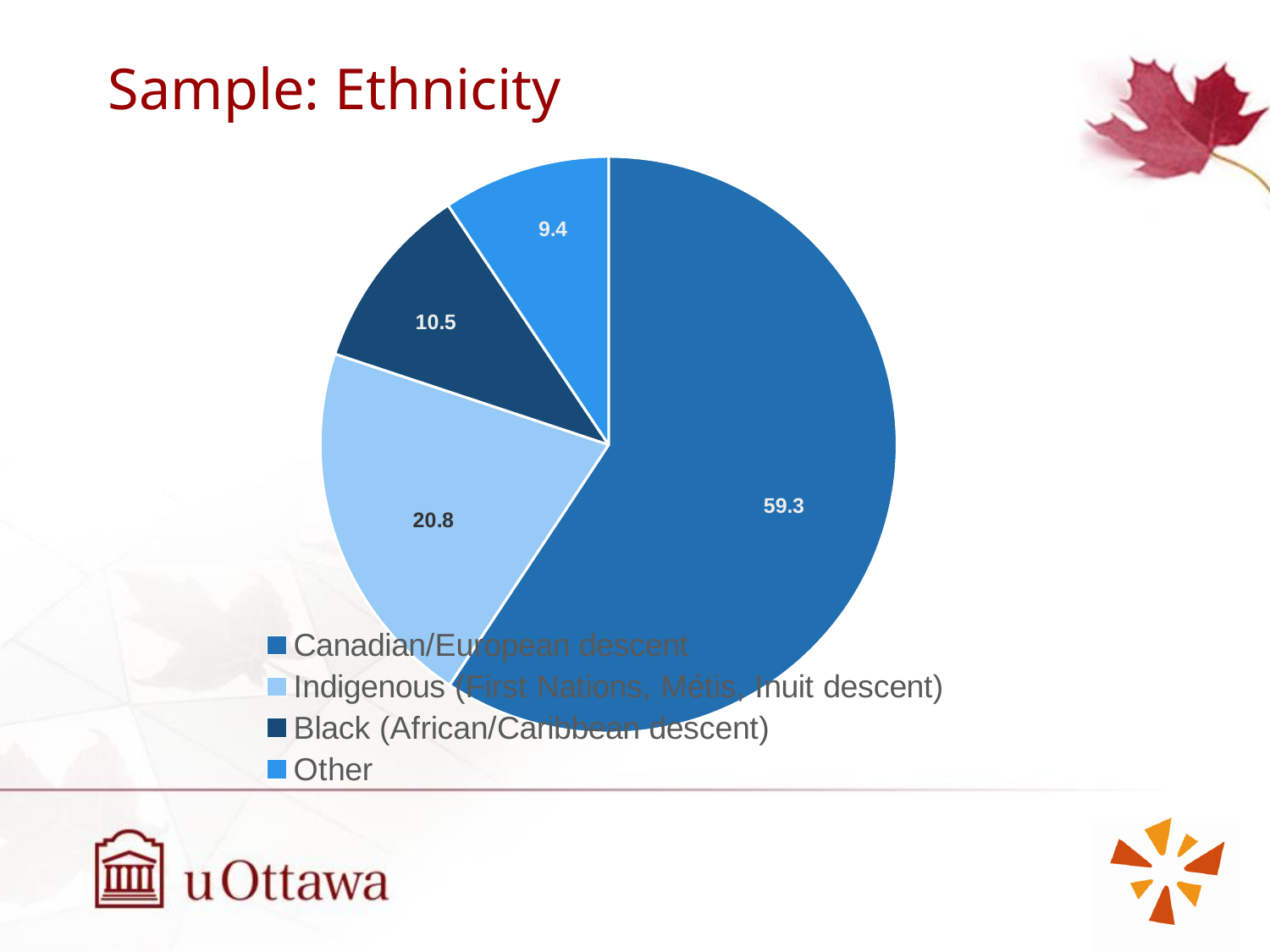
What is the value for Canadian/European descent? 59.3 How many categories does the legend list? 4 Which category has the smallest slice? Other What is the value for Indigenous (First Nations, Métis, Inuit descent)? 20.8 What is the title of the slide containing the chart? Sample: Ethnicity What is the value for Black (African/Caribbean descent)? 10.5 What is the difference between the values for Canadian/European descent and Indigenous (First Nations, Métis, Inuit descent)? 38.5 What is the value for Other? 9.4 Which is larger, the value for Indigenous (First Nations, Métis, Inuit descent) or the value for Black (African/Caribbean descent)? Indigenous (First Nations, Métis, Inuit descent) What is the difference between the values for Black (African/Caribbean descent) and Other? 1.1 What kind of chart is shown on the slide? Pie chart Which category has the largest slice? Canadian/European descent